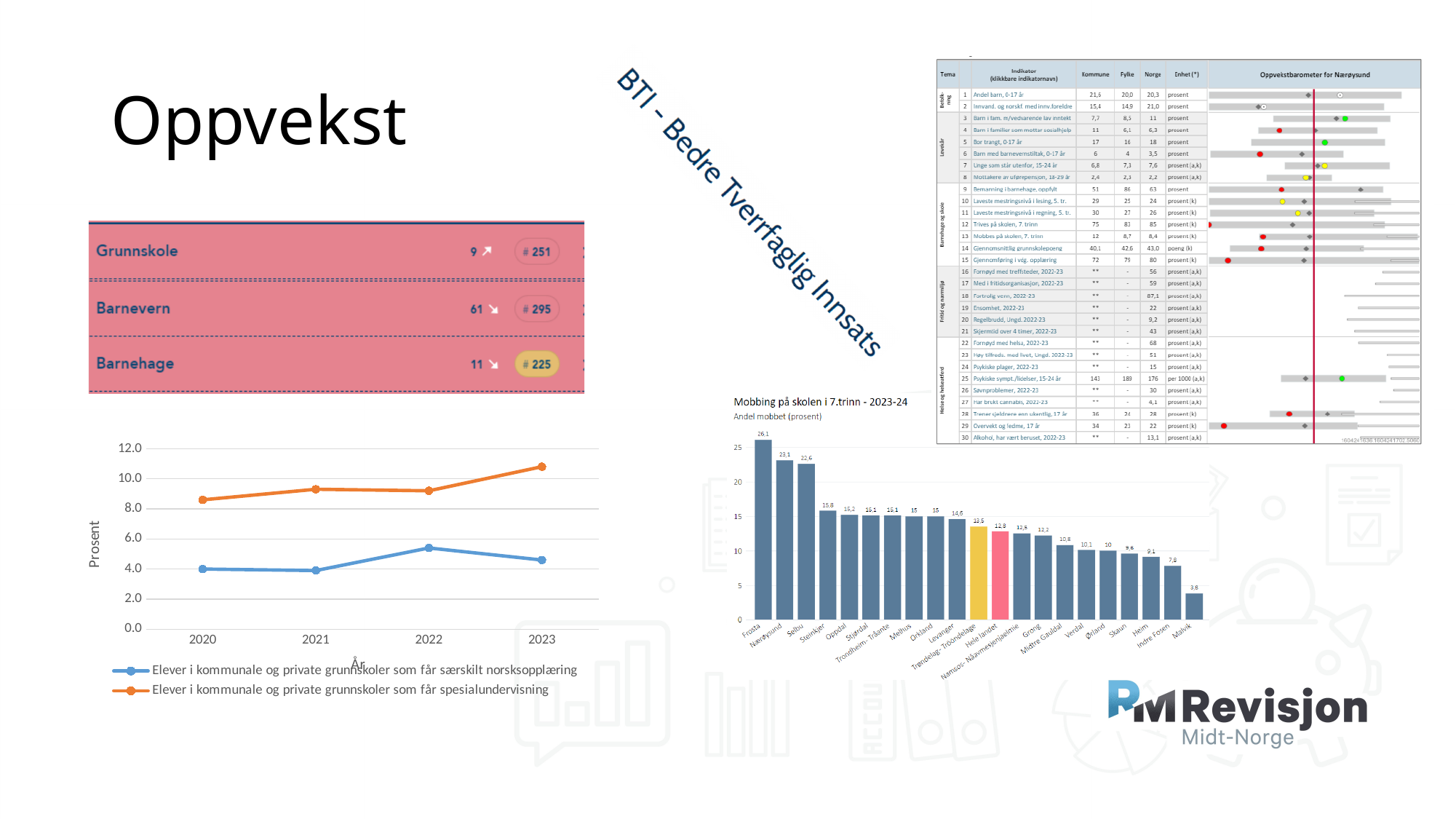
In the chart titled 'Mobbing på skolen i 7.trinn - 2023-24', what is the value for Frosta? 26,1 In the chart titled 'Mobbing på skolen i 7.trinn - 2023-24', which category has the highest value? Frosta In the chart titled 'Mobbing på skolen i 7.trinn - 2023-24', what is the value for Hele landet? 12,8 In the chart titled 'Mobbing på skolen i 7.trinn - 2023-24', how many bars are plotted? 21 In the line chart at the bottom left of the slide, what is the label on the y axis? Prosent In the chart titled 'Mobbing på skolen i 7.trinn - 2023-24', which category has the lowest value? Malvik In the line chart at the bottom left of the slide, is the 2020 value for 'Elever i kommunale og private grunnskoler som får særskilt norskopplæring' greater or less than 6.0? less What kind of chart is the chart titled 'Mobbing på skolen i 7.trinn - 2023-24'? Bar chart In the chart titled 'Mobbing på skolen i 7.trinn - 2023-24', which is larger, the value for Steinkjer or the value for Grong? Steinkjer In the line chart at the bottom left of the slide, how many series does the legend list? 2 In the chart titled 'Mobbing på skolen i 7.trinn - 2023-24', what is the difference between the values for Nærøysund and Selbu? 0,5 In the line chart at the bottom left of the slide, is the 2023 value for 'Elever i kommunale og private grunnskoler som får spesialundervisning' greater or less than 10.0? greater